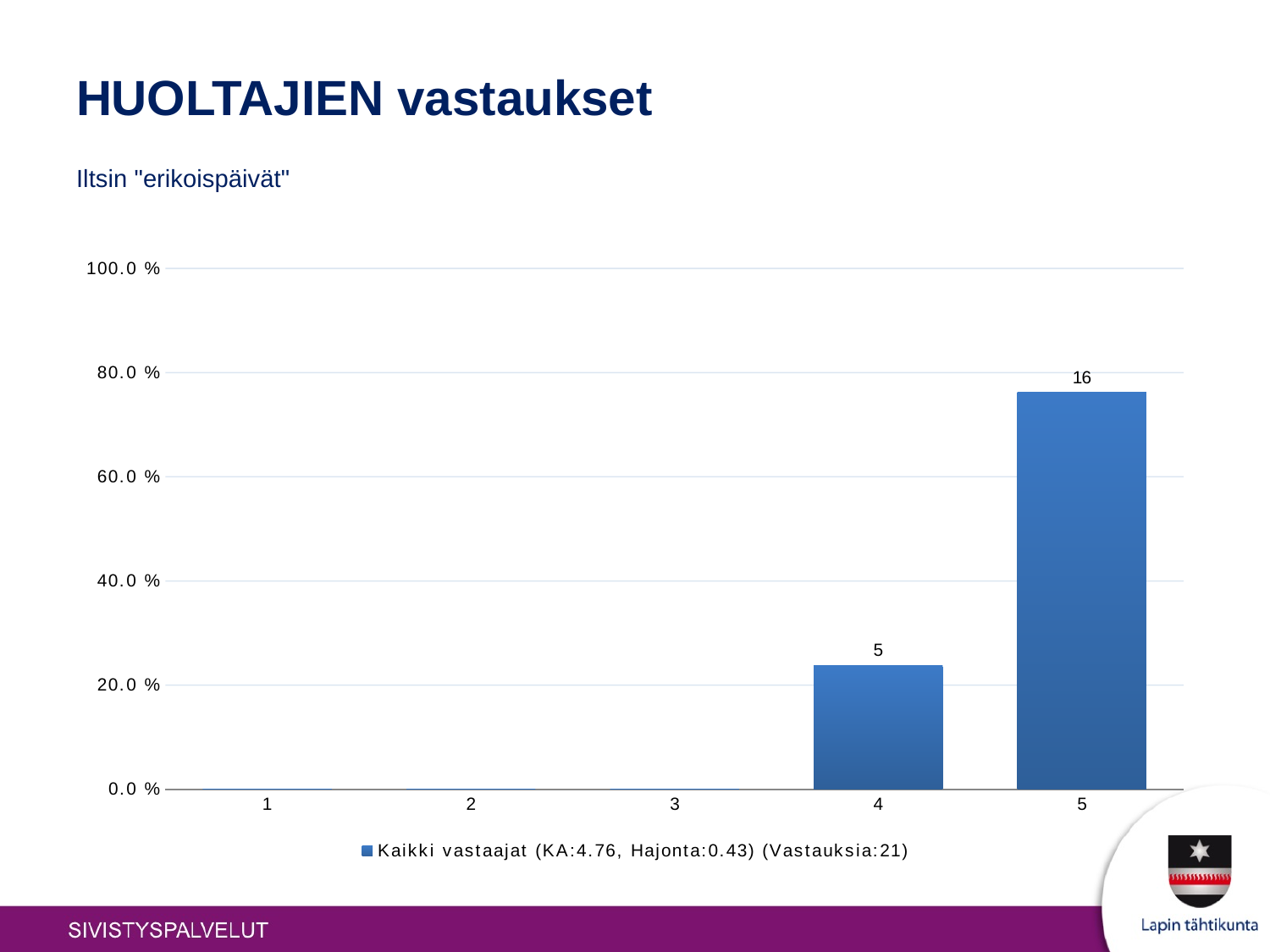
What is the legend entry of the chart? Kaikki vastaajat (KA:4.76, Hajonta:0.43) (Vastauksia:21) What data label is shown on the bar for category 4? 5 What data label is shown on the bar for category 5? 16 Do the bar heights rise or fall from category 1 to category 5? rise Which category has the highest bar in the chart? 5 Is the bar for category 4 greater or less than 40.0 %? less What is the difference between the data labels for category 5 and category 4? 11 Which bar is taller, category 4 or category 5? 5 How many series does the chart legend list? 1 Is the bar for category 5 greater or less than 60.0 %? greater How many categories are shown on the x axis of the chart? 5 What type of chart is shown on the slide? bar chart